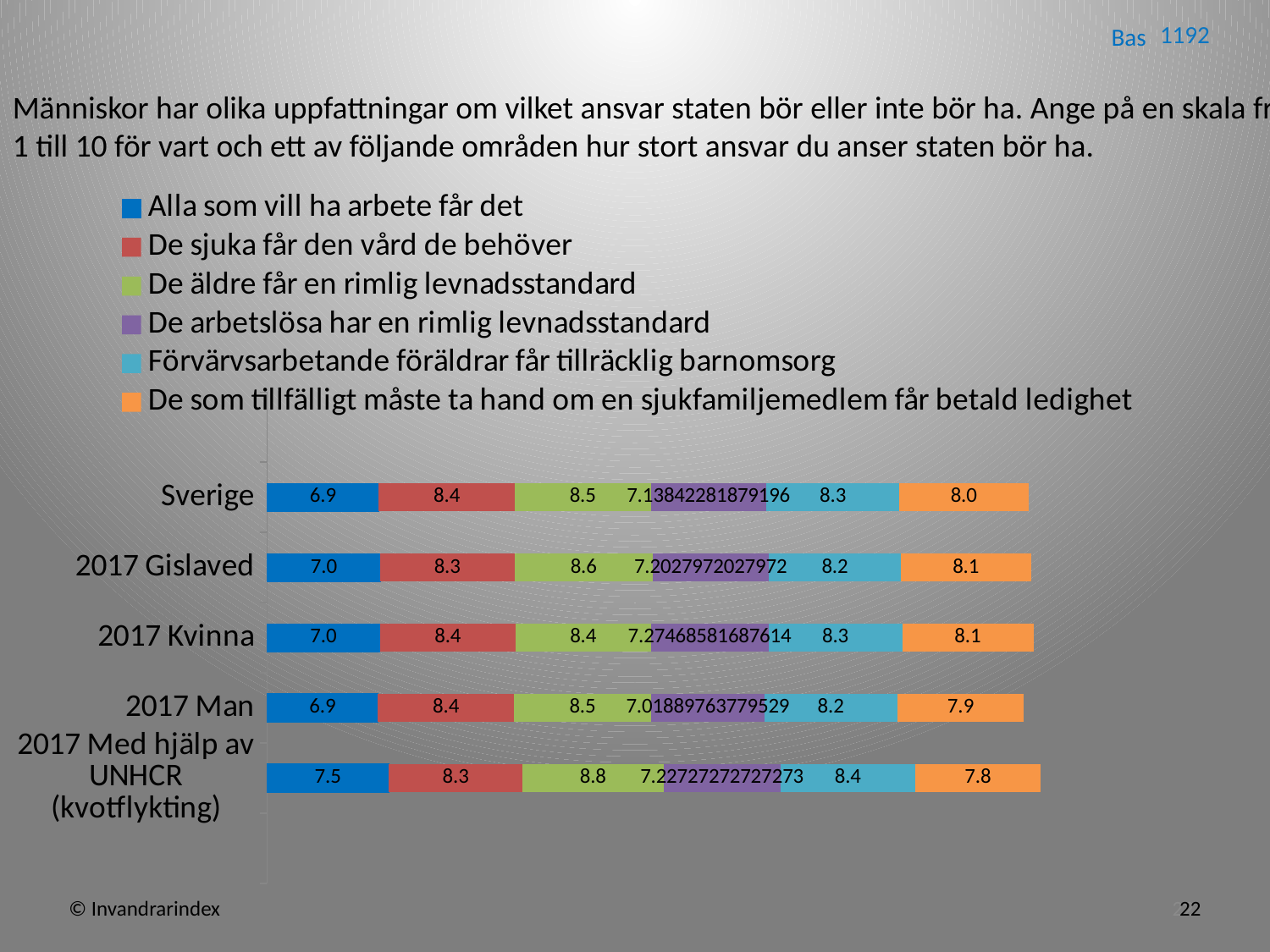
Which is larger: the 'De sjuka får den vård de behöver' value for Sverige or for 2017 Gislaved? Sverige What kind of chart is shown on the slide? Stacked bar chart Which category has the lowest value for 'De som tillfälligt måste ta hand om en sjukfamiljemedlem får betald ledighet'? 2017 Med hjälp av UNHCR (kvotflykting) What is the value for 'Alla som vill ha arbete får det' in the Sverige bar? 6.9 What colour represents 'De äldre får en rimlig levnadsstandard' in the chart? Green Which category has the highest value for 'Alla som vill ha arbete får det'? 2017 Med hjälp av UNHCR (kvotflykting) What is the difference between the 'De äldre får en rimlig levnadsstandard' values for '2017 Med hjälp av UNHCR (kvotflykting)' and 2017 Kvinna? 0.4 What is the value for 'De som tillfälligt måste ta hand om en sjukfamiljemedlem får betald ledighet' in the 2017 Man bar? 7.9 How many series does the legend list? 6 How many categories (bars) are shown in the chart? 5 What is the value for 'De äldre får en rimlig levnadsstandard' in the '2017 Med hjälp av UNHCR (kvotflykting)' bar? 8.8 What is the value for 'Förvärvsarbetande föräldrar får tillräcklig barnomsorg' in the 2017 Gislaved bar? 8.2